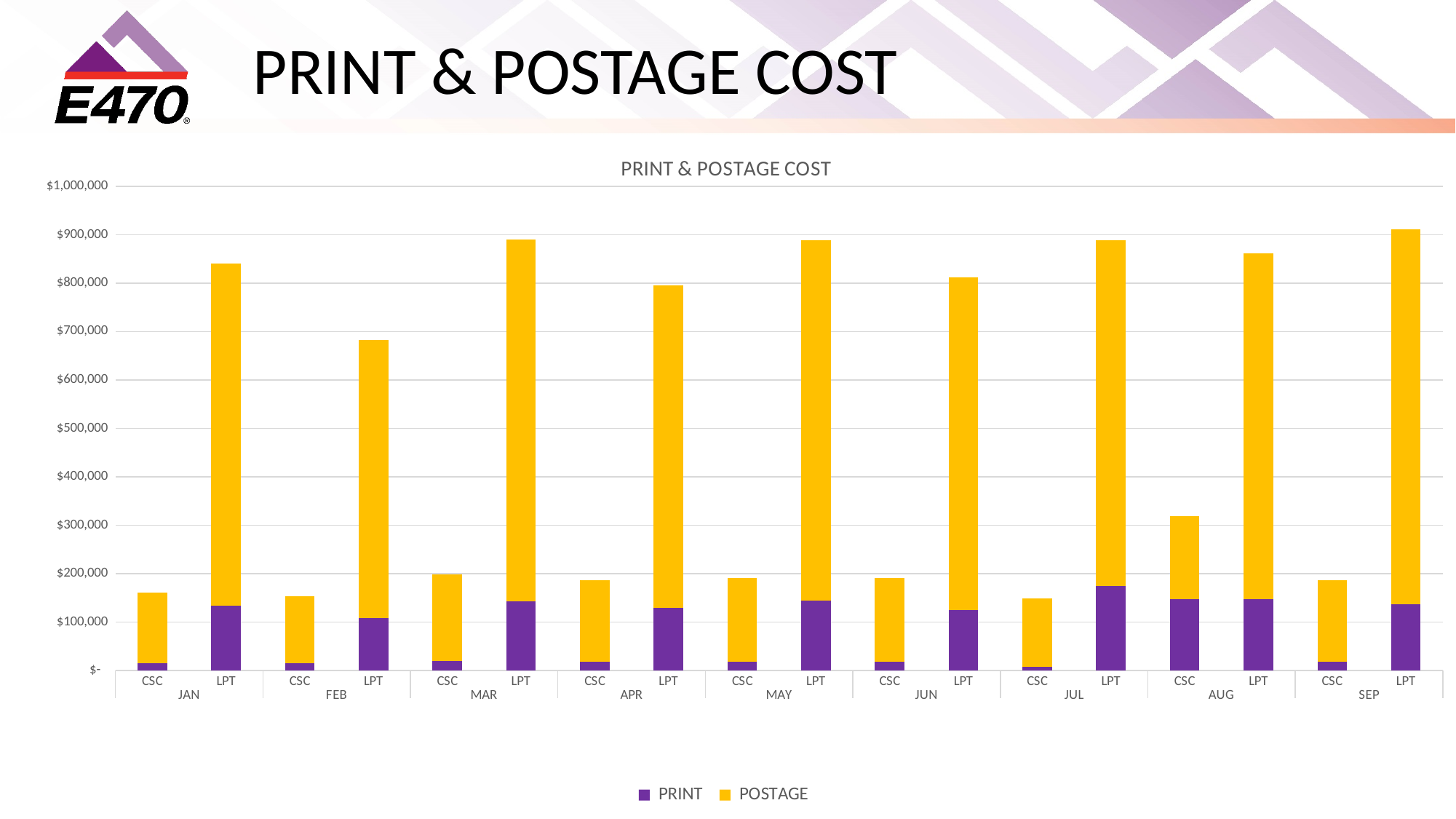
Is the total for FEB LPT greater or less than $700,000? less Is the total for JAN LPT greater or less than $800,000? greater Which bar has the highest total cost? SEP LPT What kind of chart is shown on the slide? Stacked bar chart How many bars are plotted in total? 18 Which is larger, the total for JAN LPT or FEB LPT? JAN LPT How many series does the legend list? 2 Which colour represents POSTAGE in the chart? Yellow Among the CSC bars, which month has the highest total? AUG Which two series are shown in the legend? PRINT and POSTAGE How many months are shown along the x axis? 9 Is the total for AUG CSC greater or less than $300,000? greater